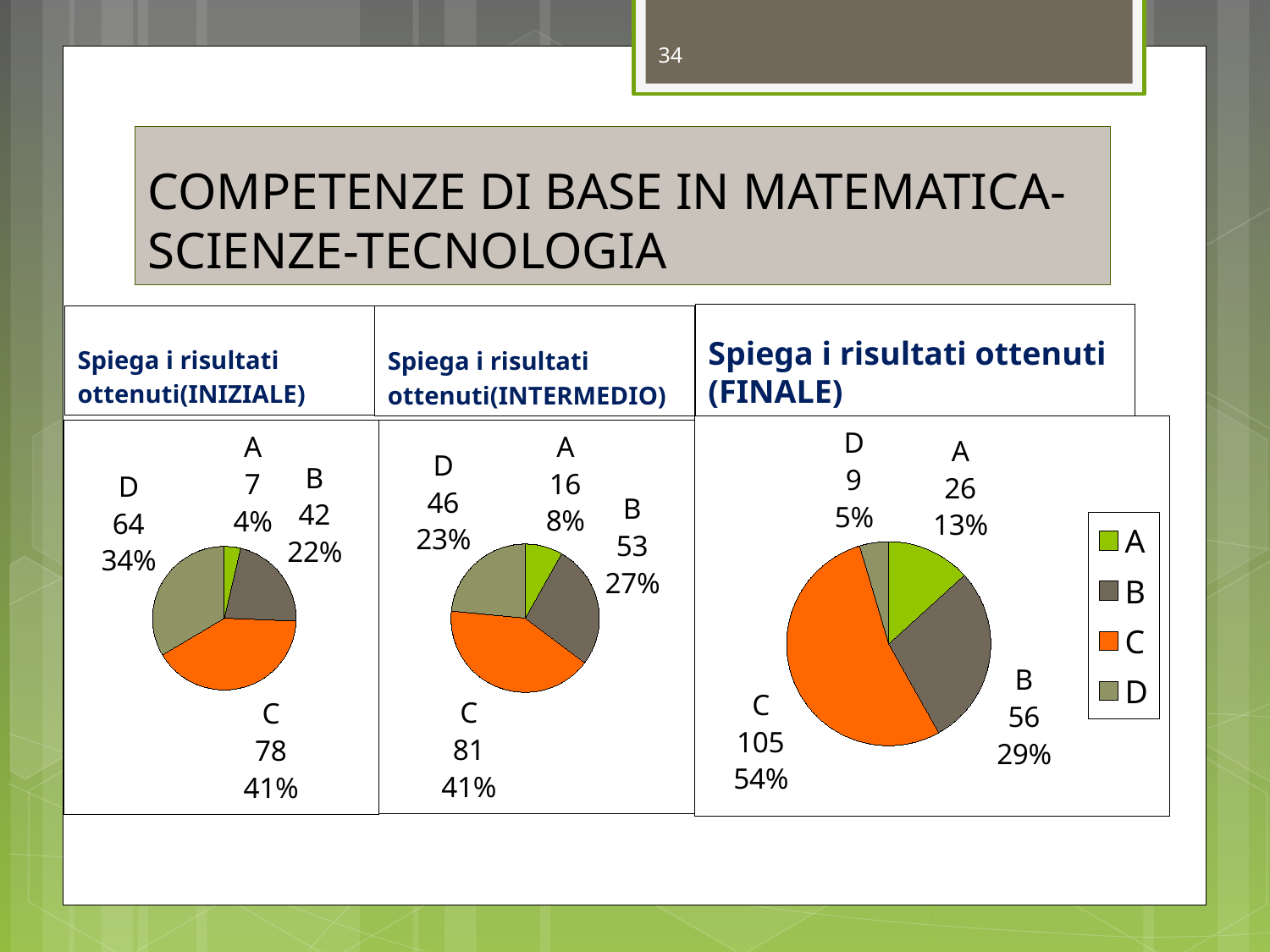
How many categories does the FINALE pie chart show? 4 In the INIZIALE pie chart, which category has the smallest value? A In the INIZIALE pie chart, what is the value for category C? 78 In the INTERMEDIO pie chart, what is the difference between the values for C and D? 35 In the FINALE pie chart, which colour represents category C in the legend? Orange In the INTERMEDIO pie chart, which category has the largest value? C In the FINALE pie chart, what share of the pie does category B represent? 29% In the FINALE pie chart, which is larger, the value for A or the value for D? A In the FINALE pie chart, what is the value for category C? 105 In the INIZIALE pie chart, what share of the pie does category D represent? 34% What type of chart is used in the FINALE panel? Pie chart In the INTERMEDIO pie chart, what is the value for category B? 53